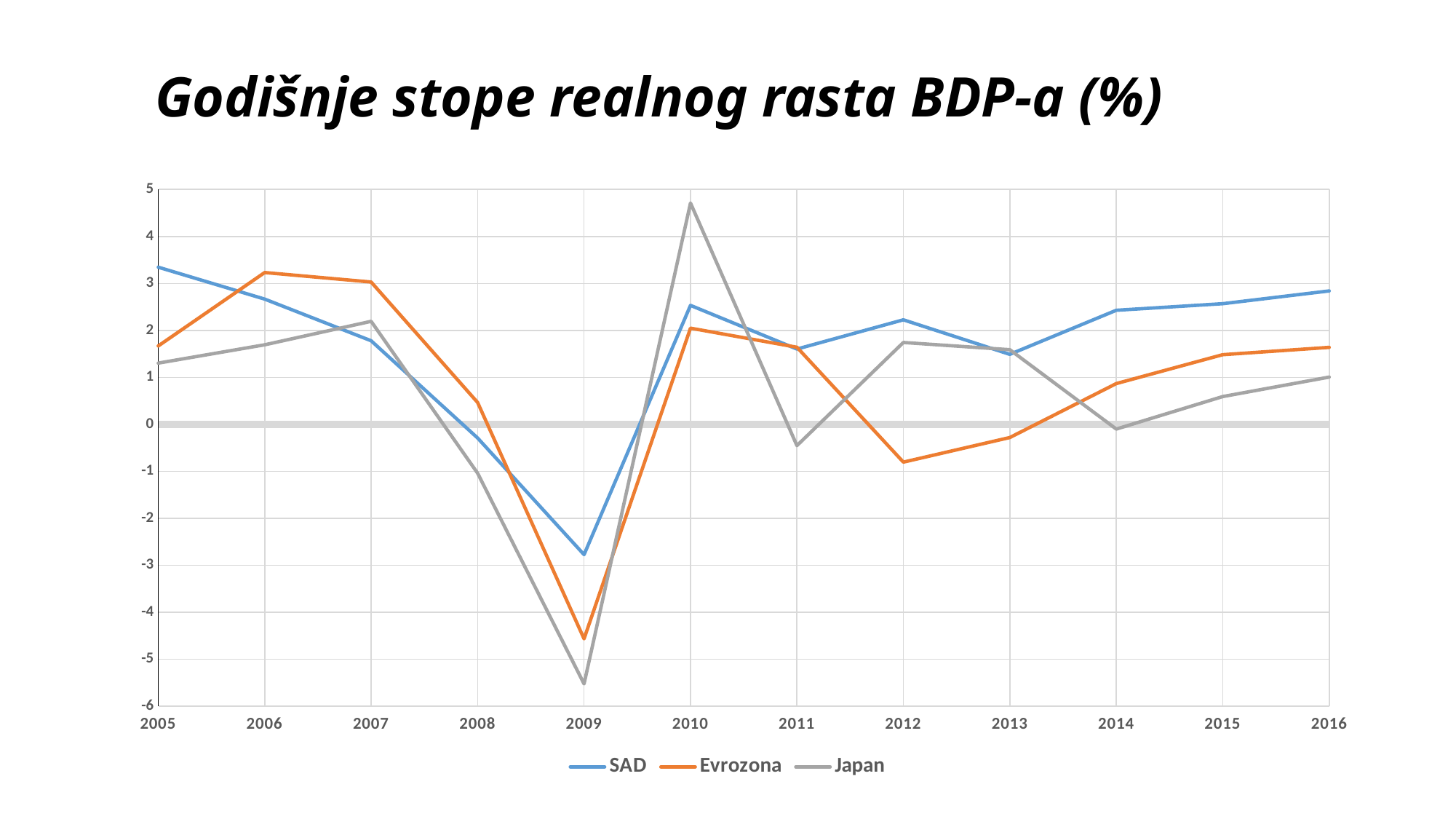
In 2006, which is higher: SAD or Evrozona? Evrozona Which series has the highest value in 2010? Japan What is the title of the chart? Godišnje stope realnog rasta BDP-a (%) Is the value for Japan in 2010 greater or less than 4? greater What kind of chart is shown on the slide? line chart Is the value for Evrozona in 2012 greater or less than 0? less In which year does the SAD series reach its lowest value? 2009 How many years are shown on the x axis? 12 Which series has the lowest value in 2009? Japan Does the SAD series rise or fall from 2013 to 2016? rise How many series does the legend list? 3 Is the value for SAD in 2009 greater or less than -2? less